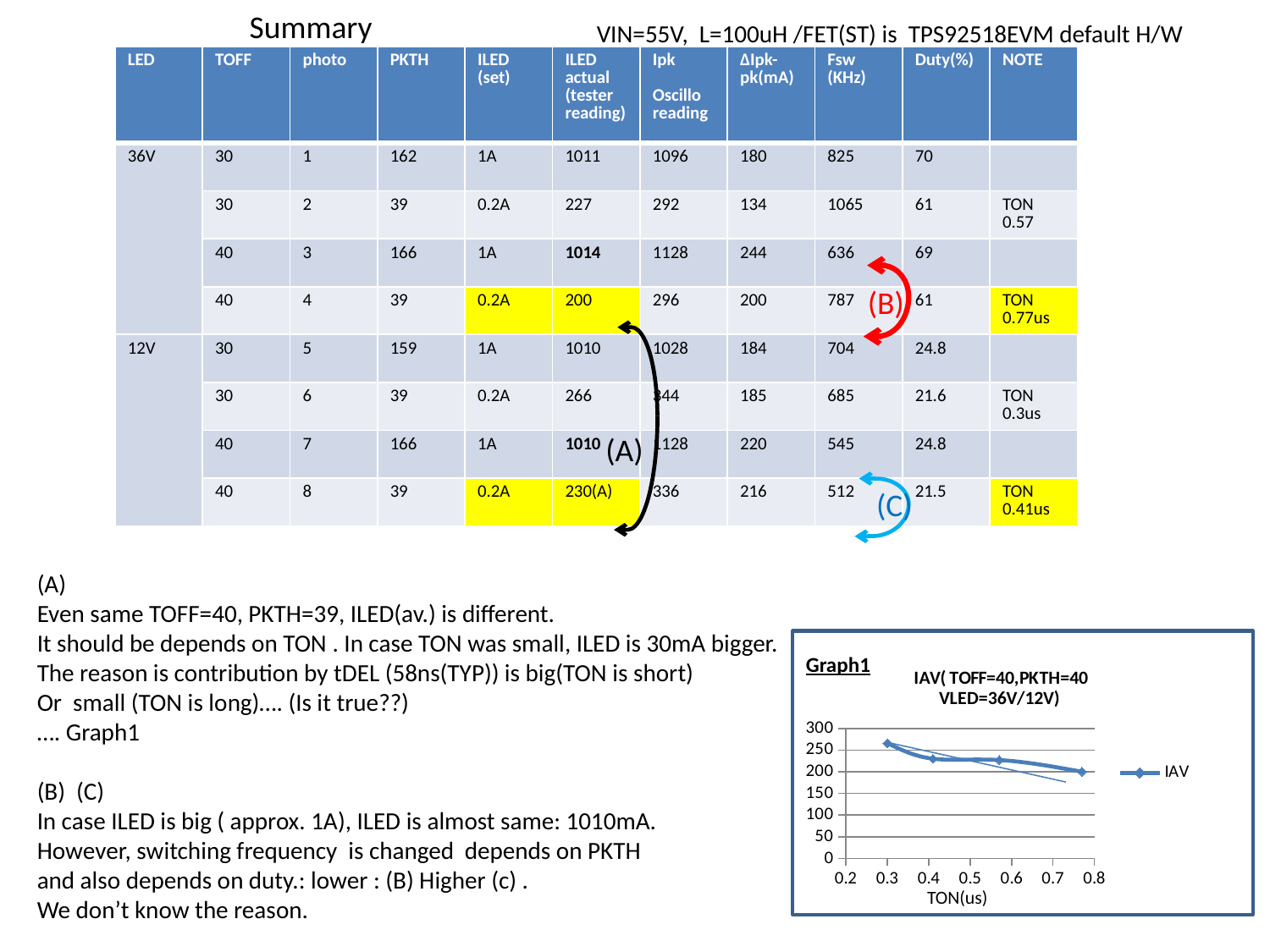
In Graph1, is the IAV value at the rightmost plotted point (around TON 0.8us) greater or less than 250? less How many series does the legend of Graph1 list? 1 What kind of chart is Graph1 on the slide? line chart What is the name of the series shown in the legend of Graph1? IAV In Graph1, are all plotted IAV values greater or less than 100? greater In Graph1, is the IAV value at the leftmost plotted point (around TON 0.3us) greater or less than 200? greater How many data points are plotted for the IAV series in Graph1? 4 What is the label of the x axis in Graph1? TON(us) In Graph1, do the IAV values rise or fall as TON(us) increases along the x axis? fall In Graph1, which plotted point has the larger IAV value: the leftmost point or the rightmost point? the leftmost point